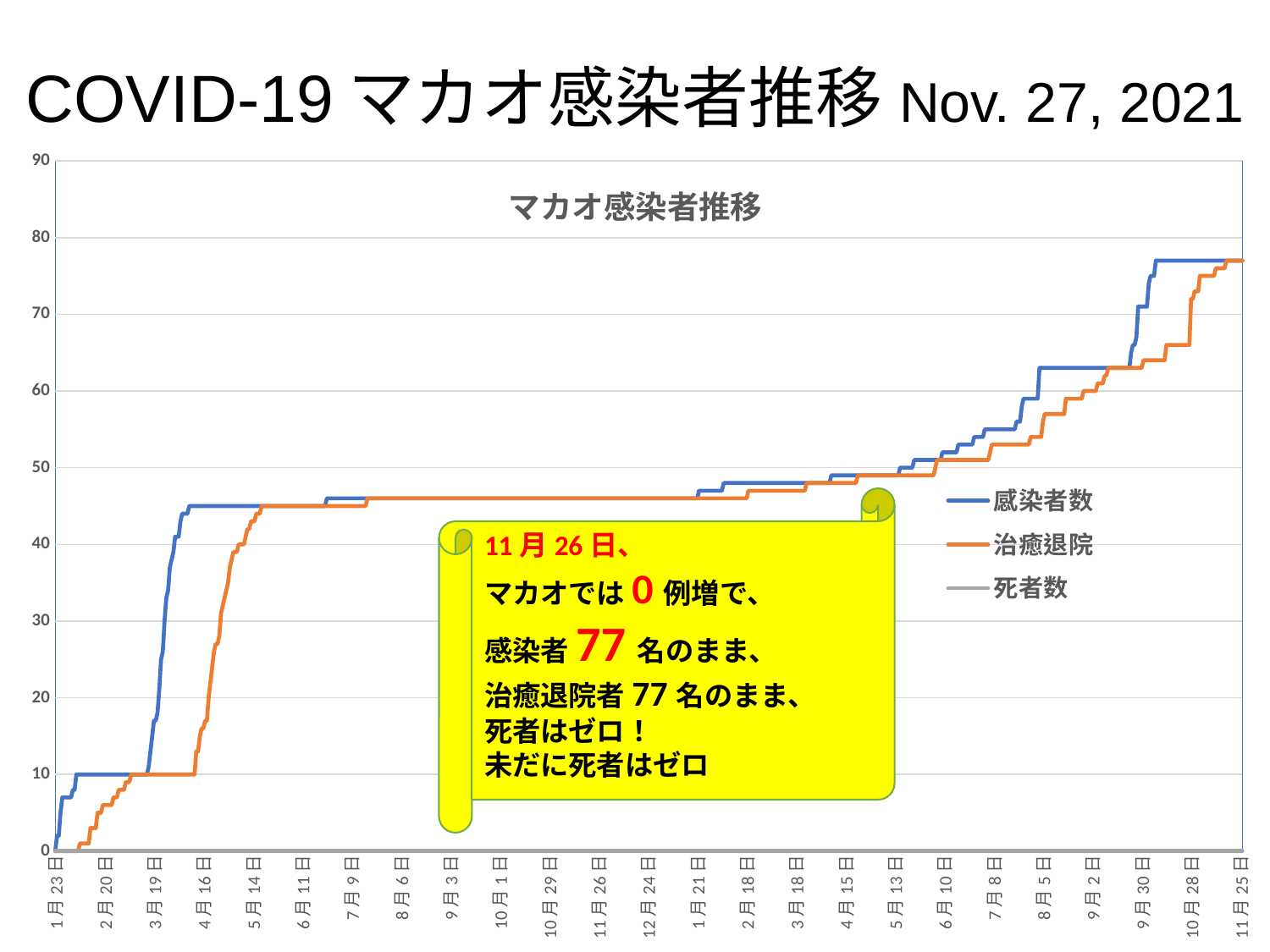
According to the slide, what is the number of 感染者 (infected) as of 11月26日? 77 According to the slide, what is the number of 治癒退院者 (recovered/discharged) as of 11月26日? 77 What value does the 死者数 series stay at throughout the chart? 0 Which series has the lowest values across the whole chart? 死者数 Is the value of 感染者数 at 4月16日 greater or less than 40? greater Does the 感染者数 series generally rise or fall from left to right along the x axis? rise At 4月16日, which is larger: 感染者数 or 治癒退院? 感染者数 Which series is drawn in orange according to the legend? 治癒退院 What is the title of the chart? マカオ感染者推移 Is the value of 治癒退院 at 3月19日 greater or less than 20? less How many series does the chart's legend list? 3 What kind of chart is shown on the slide? line chart